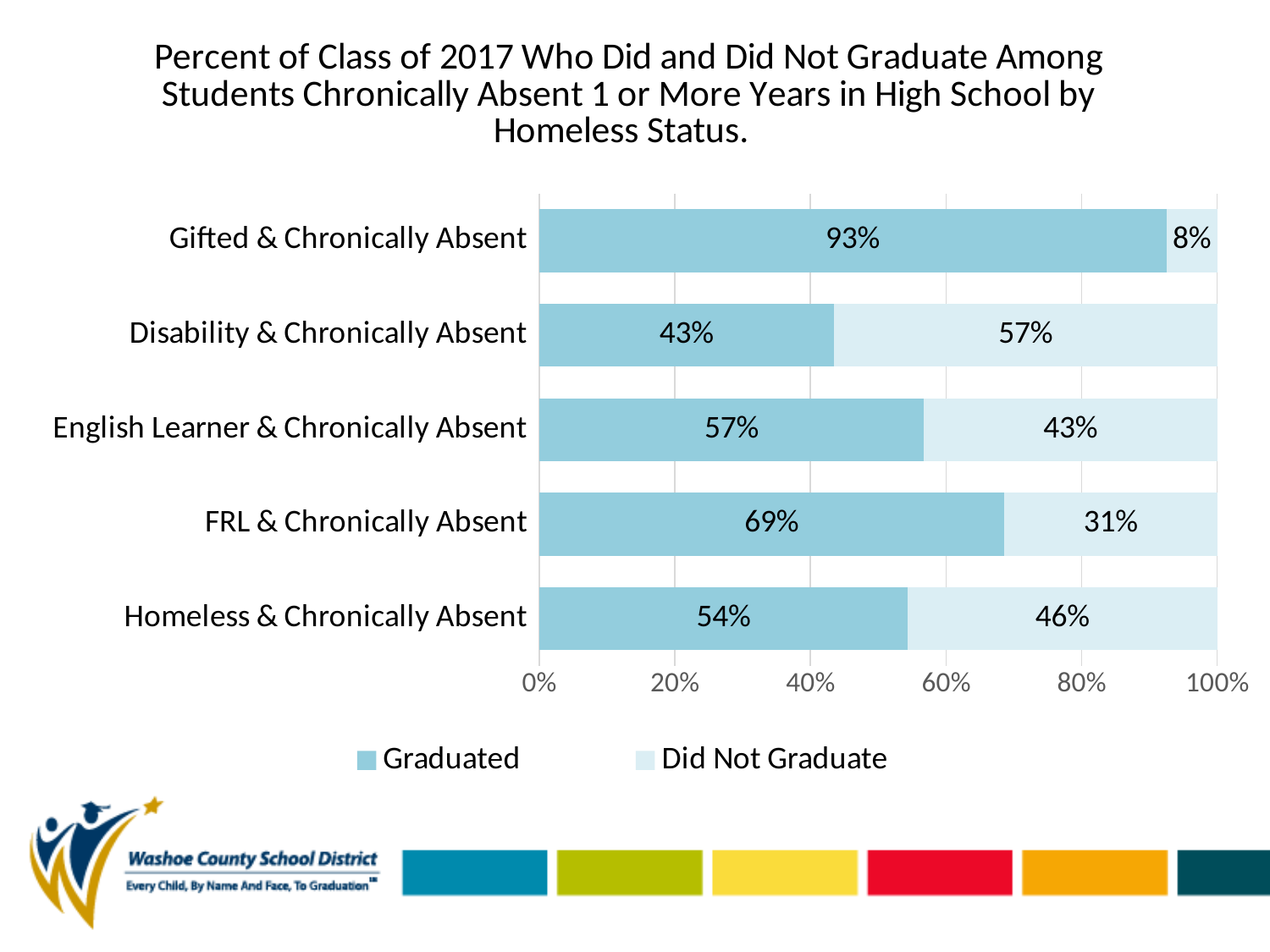
Which category has the lowest Graduated percentage? Disability & Chronically Absent How many series does the legend list? 2 What percent of Disability & Chronically Absent students did not graduate? 57% What kind of chart is shown on the slide? Stacked bar chart How many categories are shown on the chart? 5 What is the difference between the Graduated percentages for FRL & Chronically Absent and Homeless & Chronically Absent? 15% What are the two series named in the legend? Graduated and Did Not Graduate Which is larger: the Graduated value for English Learner & Chronically Absent or for Homeless & Chronically Absent? English Learner & Chronically Absent What is the Did Not Graduate value for FRL & Chronically Absent students? 31% Which category has the highest Graduated percentage? Gifted & Chronically Absent What is the Graduated value for Homeless & Chronically Absent students? 54% What percent of Gifted & Chronically Absent students graduated? 93%